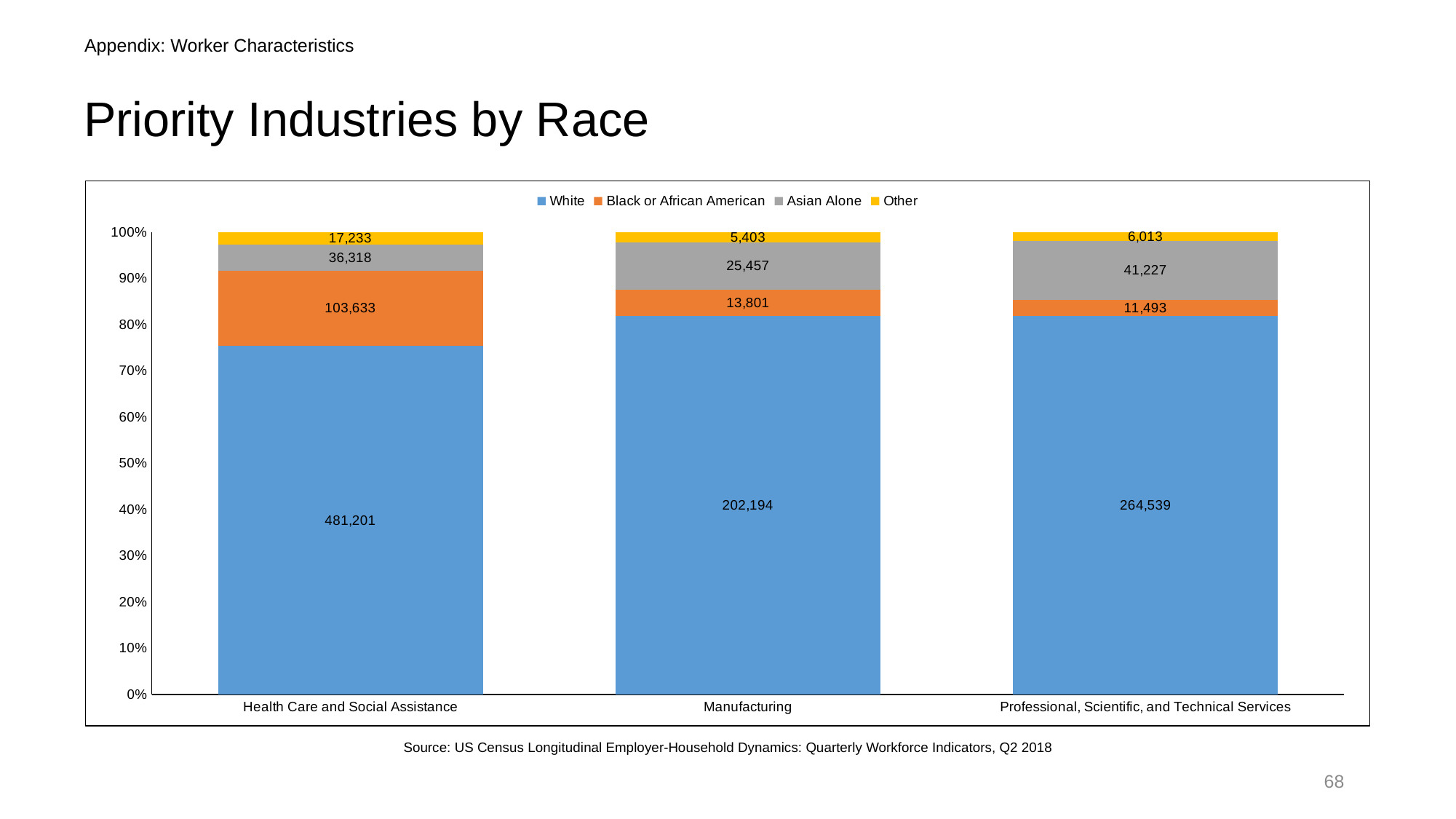
What is the value for Asian Alone in Professional, Scientific, and Technical Services? 41,227 What is the value for White in Health Care and Social Assistance? 481,201 What is the value for Black or African American in Manufacturing? 13,801 Which industry has the highest value for Black or African American? Health Care and Social Assistance How many series does the legend list? 4 What is the value for Other in Manufacturing? 5,403 What is the total of the Manufacturing bar across all four series? 246,855 Which industry has the lowest value for White? Manufacturing How many industries are shown on the x axis? 3 What is the difference between the Asian Alone values for Professional, Scientific, and Technical Services and Manufacturing? 15,770 Is the White share of the Health Care and Social Assistance bar greater or less than 80%? less Which is larger: the Other value for Health Care and Social Assistance or for Professional, Scientific, and Technical Services? Health Care and Social Assistance